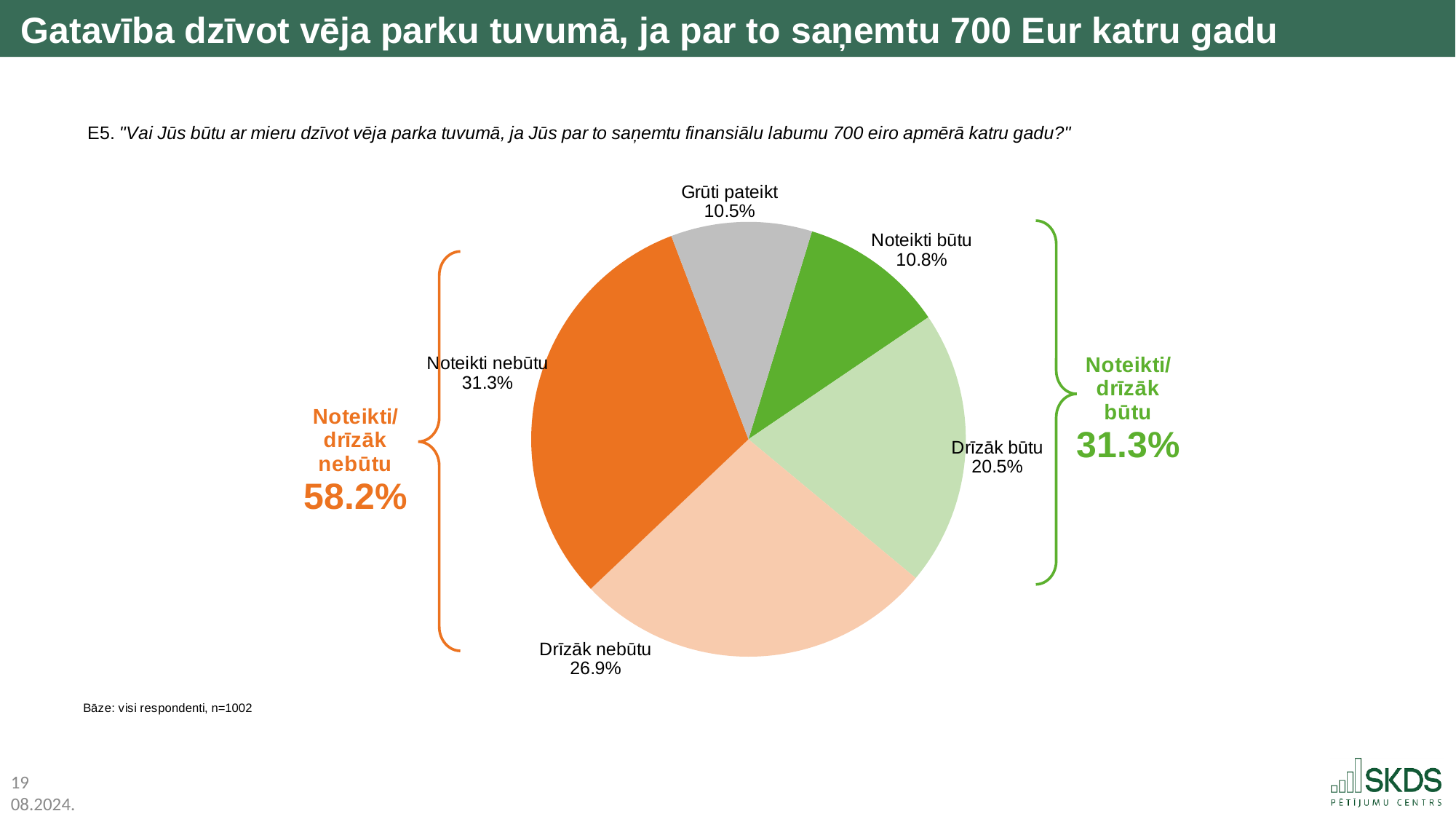
What kind of chart is shown on the slide? pie chart Which response has the smallest share of the pie? Grūti pateikt What combined percentage is shown for "Noteikti/drīzāk būtu"? 31.3% What combined percentage is shown for "Noteikti/drīzāk nebūtu"? 58.2% How many slices does the pie chart have? 5 What percentage of respondents answered "Noteikti nebūtu"? 31.3% Which response has the largest share of the pie? Noteikti nebūtu Which is larger, the share for "Drīzāk būtu" or the share for "Drīzāk nebūtu"? Drīzāk nebūtu What percentage of respondents answered "Noteikti būtu"? 10.8% What percentage of respondents answered "Drīzāk būtu"? 20.5% What is the difference in percentage points between "Noteikti nebūtu" and "Drīzāk nebūtu"? 4.4 What percentage of respondents answered "Grūti pateikt"? 10.5%